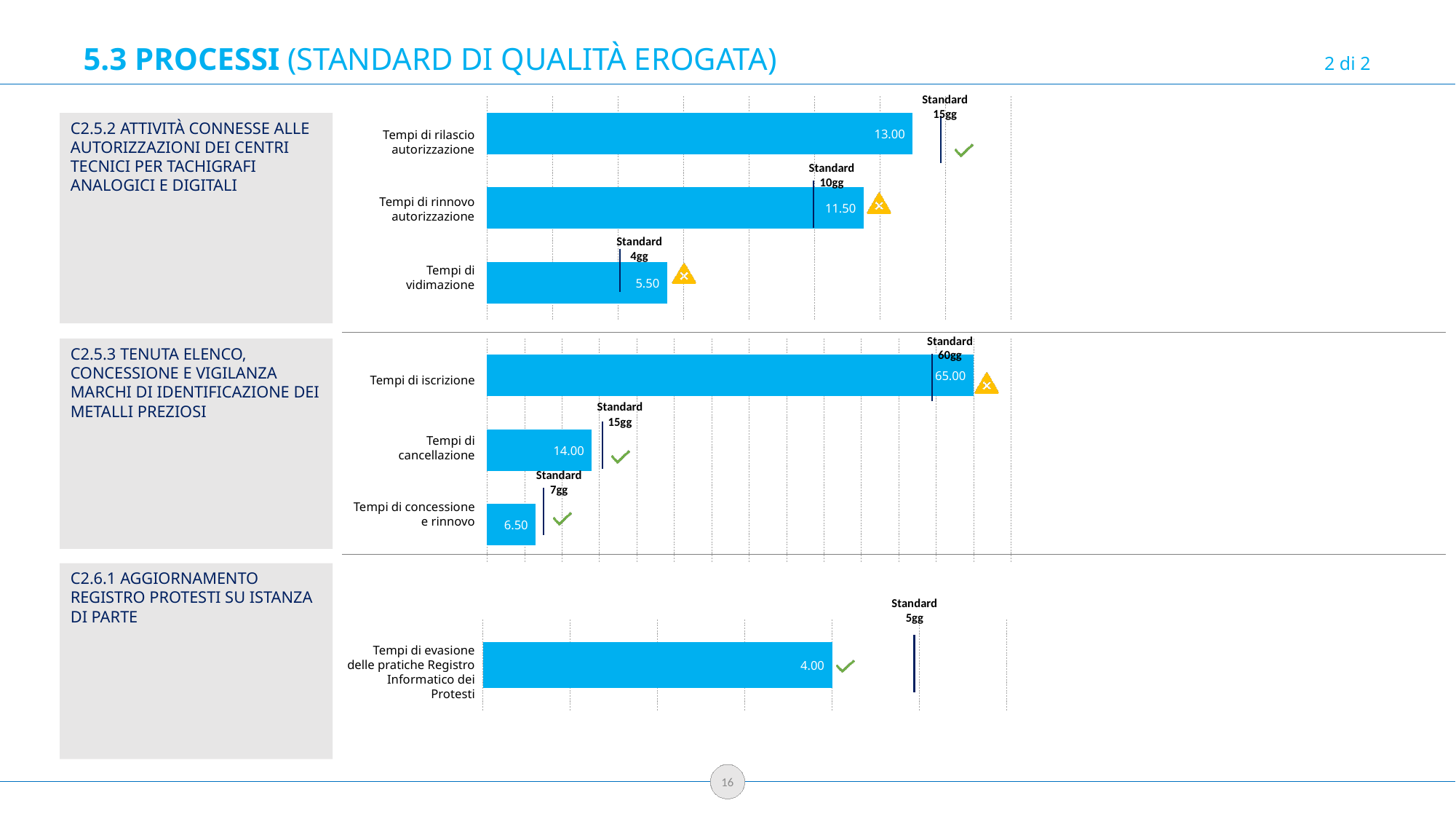
What kind of chart is the top chart (C2.5.2)? Bar chart In the middle chart (C2.5.3), how many categories are plotted? 3 In the middle chart (C2.5.3), which category has the lowest value? Tempi di concessione e rinnovo In the top chart (C2.5.2), what is the value for Tempi di rilascio autorizzazione? 13.00 In the top chart (C2.5.2), which category has the highest value? Tempi di rilascio autorizzazione In the top chart (C2.5.2), what standard is shown for Tempi di rinnovo autorizzazione? 10gg In the top chart (C2.5.2), what is the value for Tempi di vidimazione? 5.50 In the bottom chart (C2.6.1), what is the value for Tempi di evasione delle pratiche Registro Informatico dei Protesti? 4.00 In the middle chart (C2.5.3), what is the value for Tempi di iscrizione? 65.00 In the top chart (C2.5.2), what is the difference between Tempi di rilascio autorizzazione and Tempi di rinnovo autorizzazione? 1.50 In the middle chart (C2.5.3), what is the difference between Tempi di cancellazione and Tempi di concessione e rinnovo? 7.50 In the bottom chart (C2.6.1), what standard is shown for Tempi di evasione delle pratiche Registro Informatico dei Protesti? 5gg